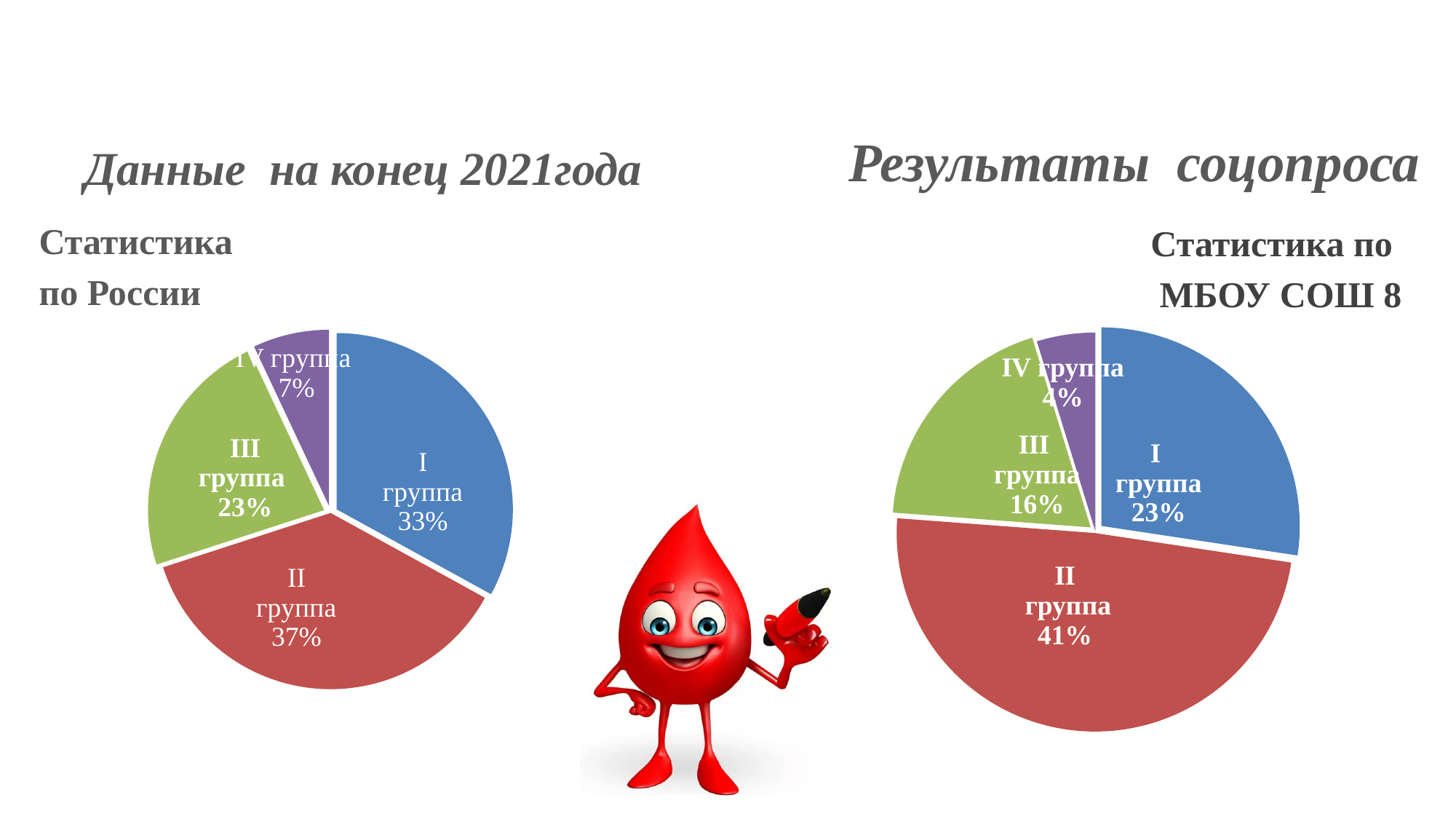
How many slices does the right pie chart (Статистика по МБОУ СОШ 8) have? 4 In the right pie chart (Статистика по МБОУ СОШ 8), what share does III группа have? 16% In the right pie chart (Статистика по МБОУ СОШ 8), which group has the smallest share? IV группа In the left pie chart (Статистика по России), what is the difference between the shares of III группа and IV группа? 16% In the left pie chart (Статистика по России), which group has the largest share? II группа What colour is the slice for II группа in both pie charts? Red In the left pie chart (Статистика по России), is the share of I группа larger or smaller than the share of III группа? Larger What type of chart is used for Статистика по России? Pie chart In the right pie chart (Статистика по МБОУ СОШ 8), what is the difference between the shares of II группа and I группа? 18% In the left pie chart (Статистика по России), what share does II группа have? 37% In the left pie chart (Статистика по России), what share does IV группа have? 7% Which chart shows a larger share for II группа: the left one (Статистика по России) or the right one (Статистика по МБОУ СОШ 8)? The right one (Статистика по МБОУ СОШ 8)